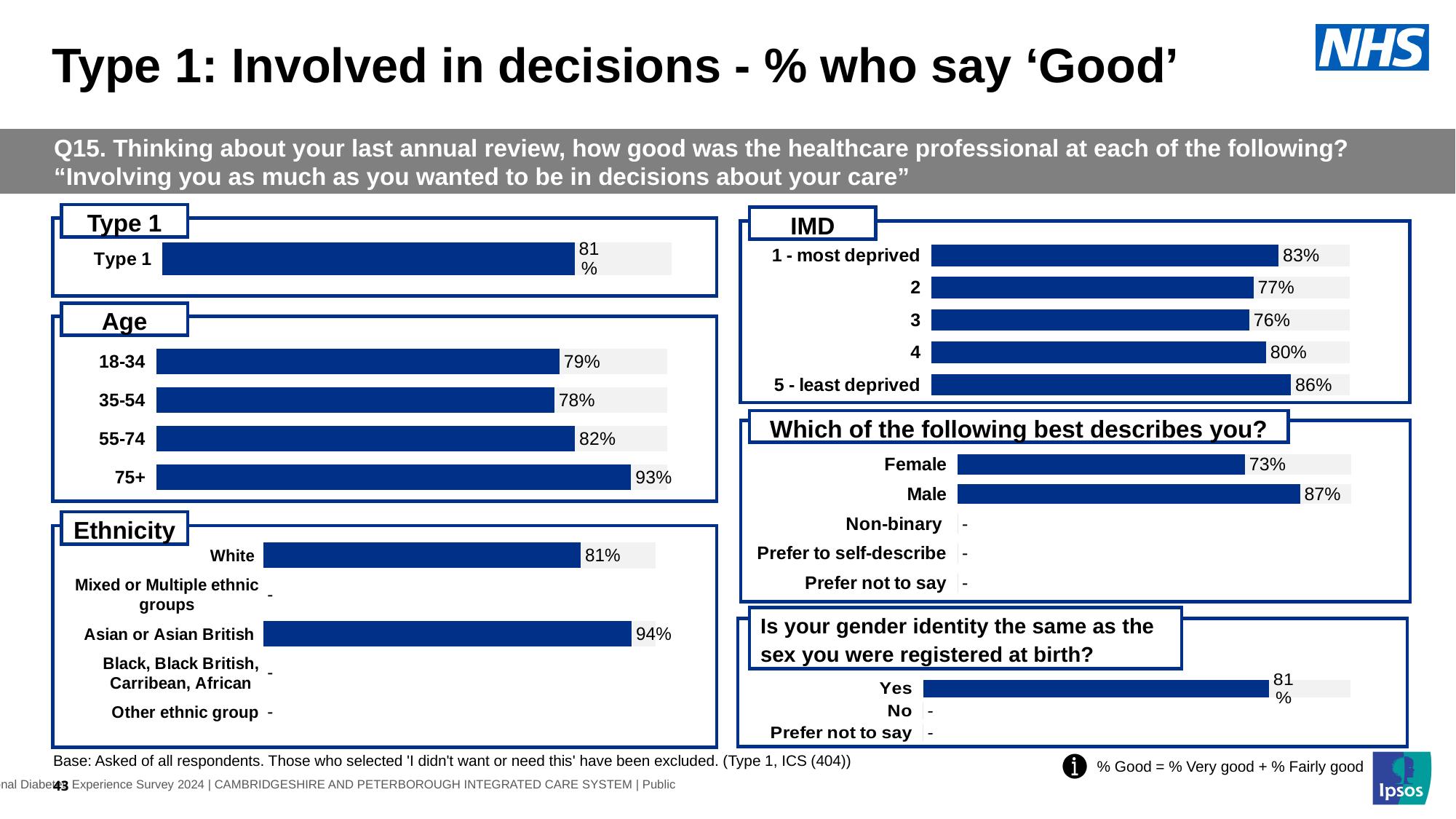
In the IMD chart, what is the difference between 1 - most deprived and 2? 6 percentage points What kind of chart is the Age chart? Bar chart In the Age chart, which age group has the lowest value? 35-54 In the Age chart, what is the value for 75+? 93% In the Age chart, which is larger, the value for 18-34 or the value for 55-74? 55-74 In the 'Which of the following best describes you?' chart, what is the difference between Male and Female? 14 percentage points In the IMD chart, which category has the lowest value? 3 In the IMD chart, which category has the highest value? 5 - least deprived In the IMD chart, what is the value for 5 - least deprived? 86% How many categories are listed in the Ethnicity chart? 5 In the Ethnicity chart, what is the value for Asian or Asian British? 94% In the 'Which of the following best describes you?' chart, what is the value for Female? 73%